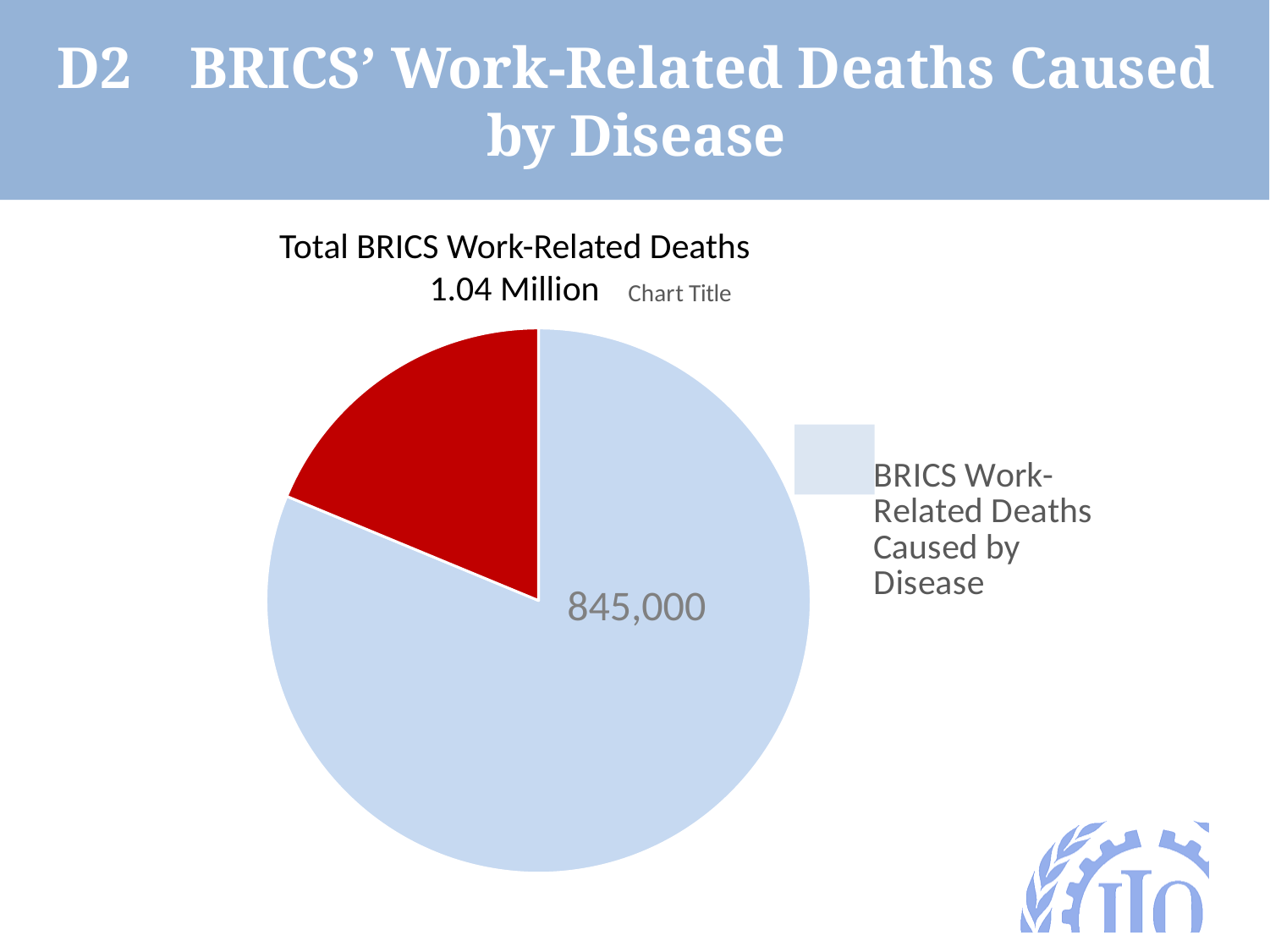
What value is printed on the slice for BRICS Work-Related Deaths Caused by Disease? 845,000 What colour is the slice labelled 845,000? Light blue Which slice of the pie is the largest? BRICS Work-Related Deaths Caused by Disease Is the red slice larger or smaller than the light blue slice? Smaller How many slices does the pie chart have? 2 How many entries does the chart's legend list? 1 What kind of chart is shown on the slide? Pie chart What total figure for BRICS work-related deaths is stated above the chart? 1.04 Million